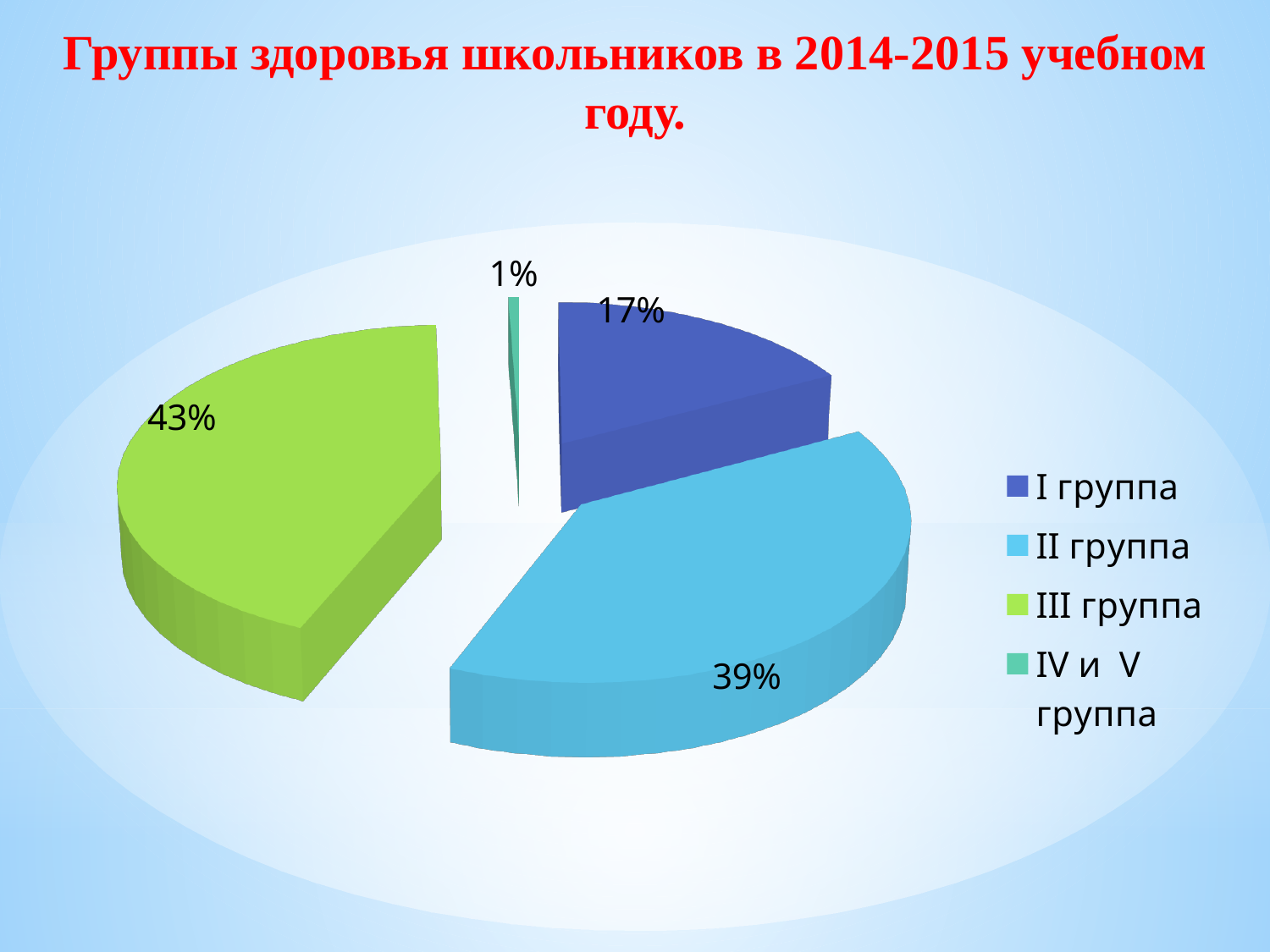
What type of chart is shown on the slide? pie chart What percentage is shown for I группа? 17% What percentage is shown for III группа? 43% Which is larger, the share for I группа or the share for II группа? II группа Which group has the smallest share of the pie? IV и V группа What is the difference in percentage points between III группа and II группа? 4 What percentage is shown for IV и V группа? 1% What is the difference in percentage points between II группа and I группа? 22 Which group has the largest share of the pie? III группа What is the title of the chart? Группы здоровья школьников в 2014-2015 учебном году. What percentage is shown for II группа? 39% How many categories does the legend list? 4